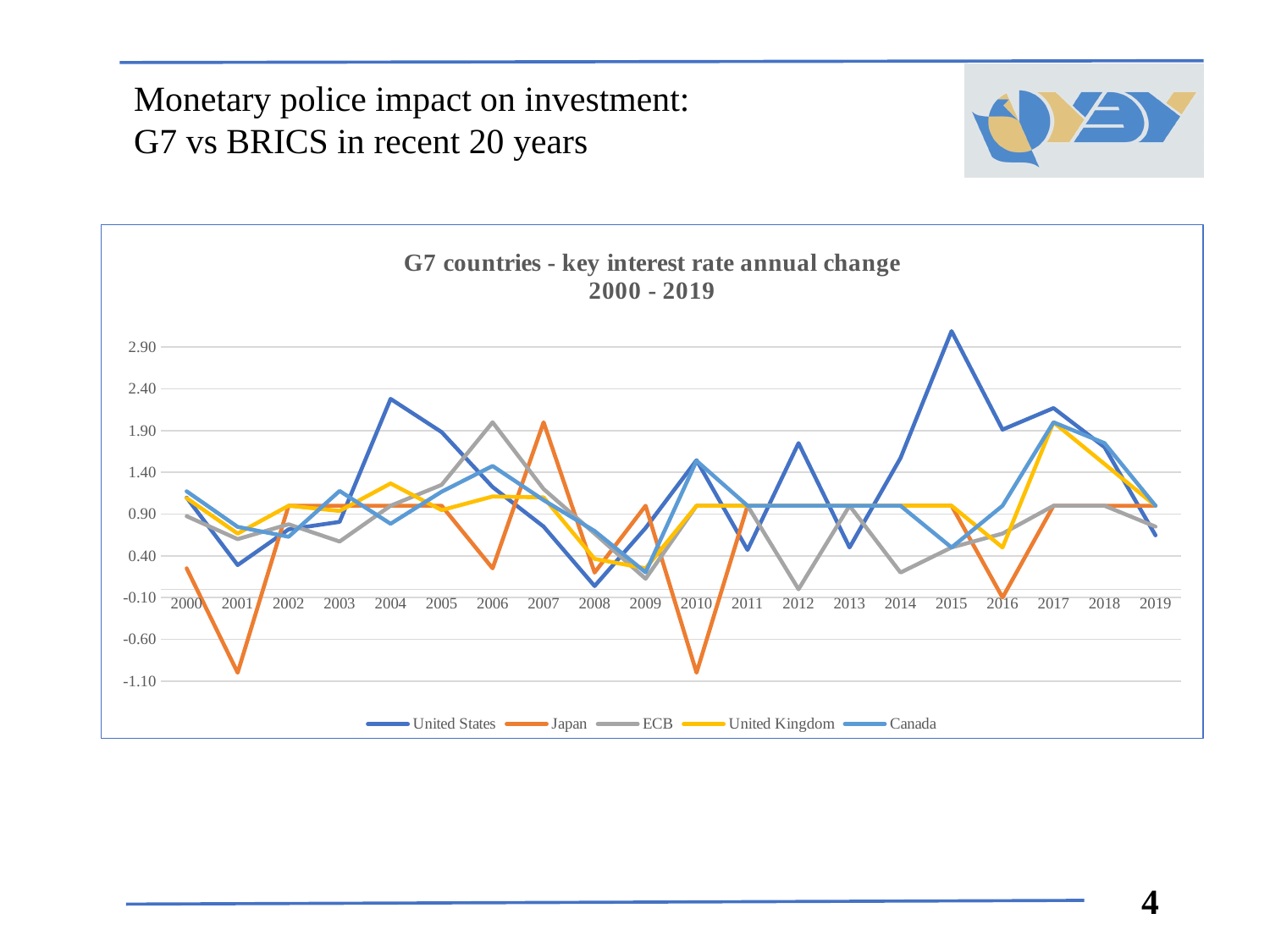
In which year does the United States series reach its lowest value? 2008 What kind of chart is shown on the slide? line chart How many series does the legend list? 5 Is the value for the United Kingdom in 2017 greater or less than 1.40? greater What is the title of the chart? G7 countries - key interest rate annual change 2000 - 2019 In 2015, which series has the larger value: United States or Canada? United States Does the United States series rise or fall from 2013 to 2015? rise Is the value for the United States in 2015 greater or less than 2.40? greater Is the value for Japan in 2001 greater or less than -0.60? less In which year does the United States series reach its highest value? 2015 How many years are plotted along the x axis? 20